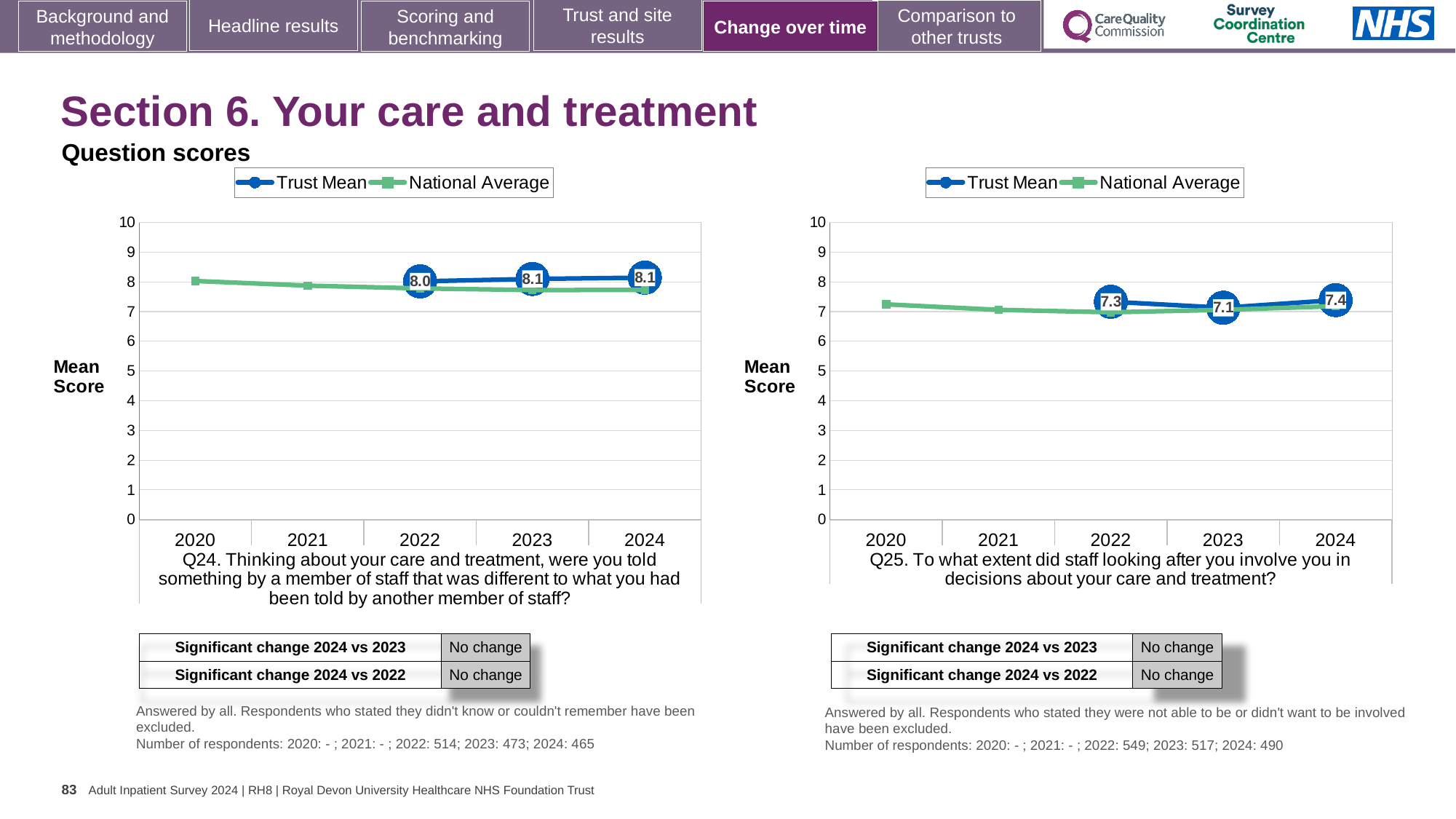
In the Q25 chart on the right, what is the Trust Mean score for 2024? 7.4 In the Q25 chart on the right, which year has the lowest Trust Mean score? 2023 In the Q24 chart on the left, is the National Average value for 2020 greater or less than 7? greater In the Q25 chart on the right, which year has the highest Trust Mean score? 2024 In the Q24 chart on the left, what is the Trust Mean score for 2022? 8.0 In the Q24 chart on the left, what is the Trust Mean score for 2024? 8.1 In the Q25 chart on the right, is the Trust Mean score higher in 2022 or in 2023? 2022 In the Q25 chart on the right, what is the Trust Mean score for 2023? 7.1 How many years are shown on the x axis of the Q25 chart on the right? 5 In the Q25 chart on the right, what is the difference between the Trust Mean scores for 2024 and 2023? 0.3 What kind of chart is the Q24 chart on the left? Line chart How many series does the legend of the Q24 chart on the left list? 2